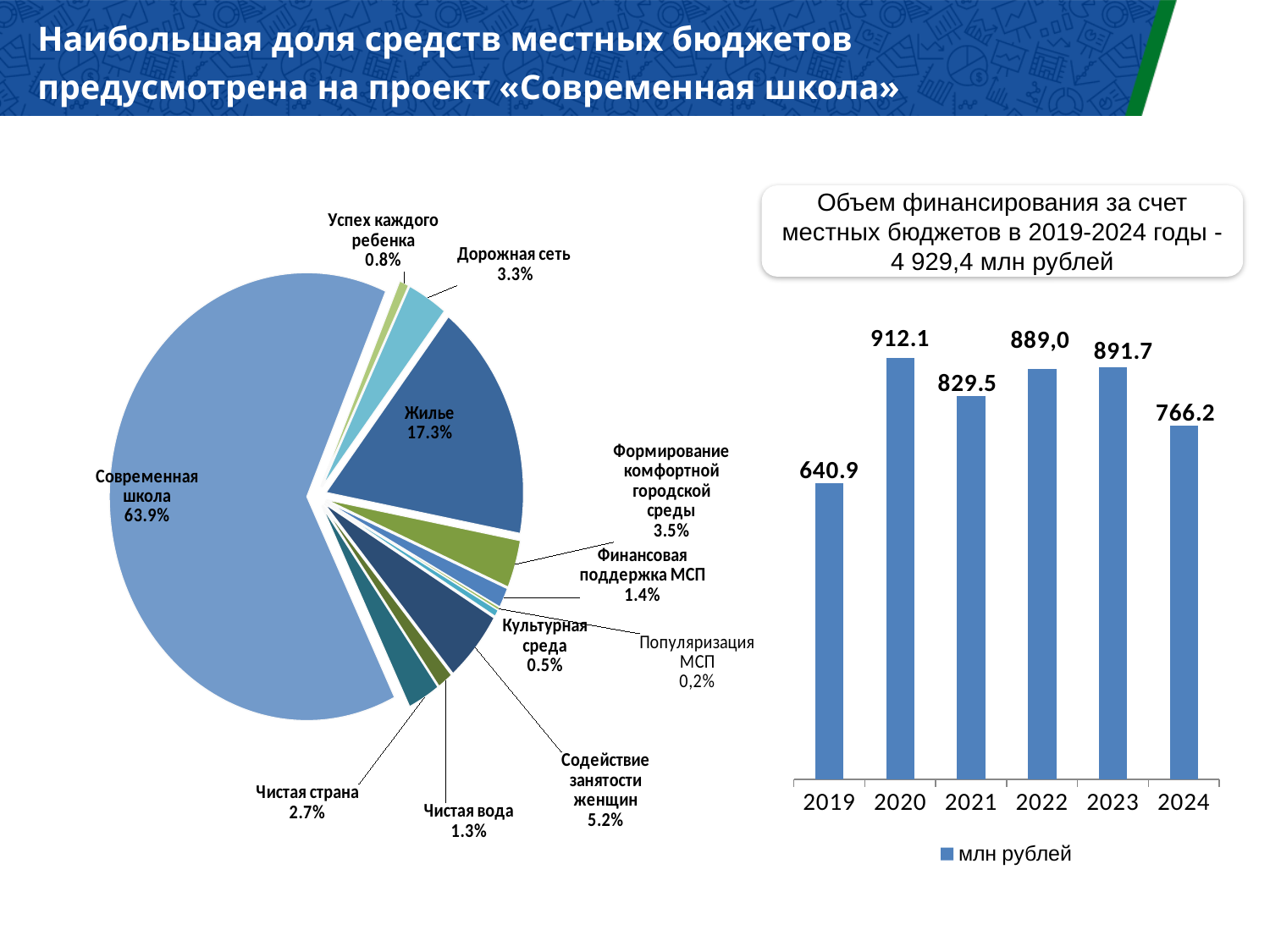
On the pie chart on the left, which is larger: «Дорожная сеть» or «Чистая страна»? Дорожная сеть On the pie chart on the left, which category has the largest share? Современная школа On the bar chart on the right, what is the difference between the values for 2020 and 2019? 271.2 On the bar chart on the right, what is the value for 2024? 766.2 On the bar chart on the right, how many years are shown? 6 On the pie chart on the left, what share does «Современная школа» have? 63.9% On the bar chart on the right, what is the legend entry? млн рублей On the pie chart on the left, how many slices are there? 11 On the pie chart on the left, which category has the smallest share? Популяризация МСП On the pie chart on the left, what share does «Жилье» have? 17.3% On the bar chart on the right, which year has the lowest value? 2019 On the bar chart on the right, what is the value for 2020? 912.1